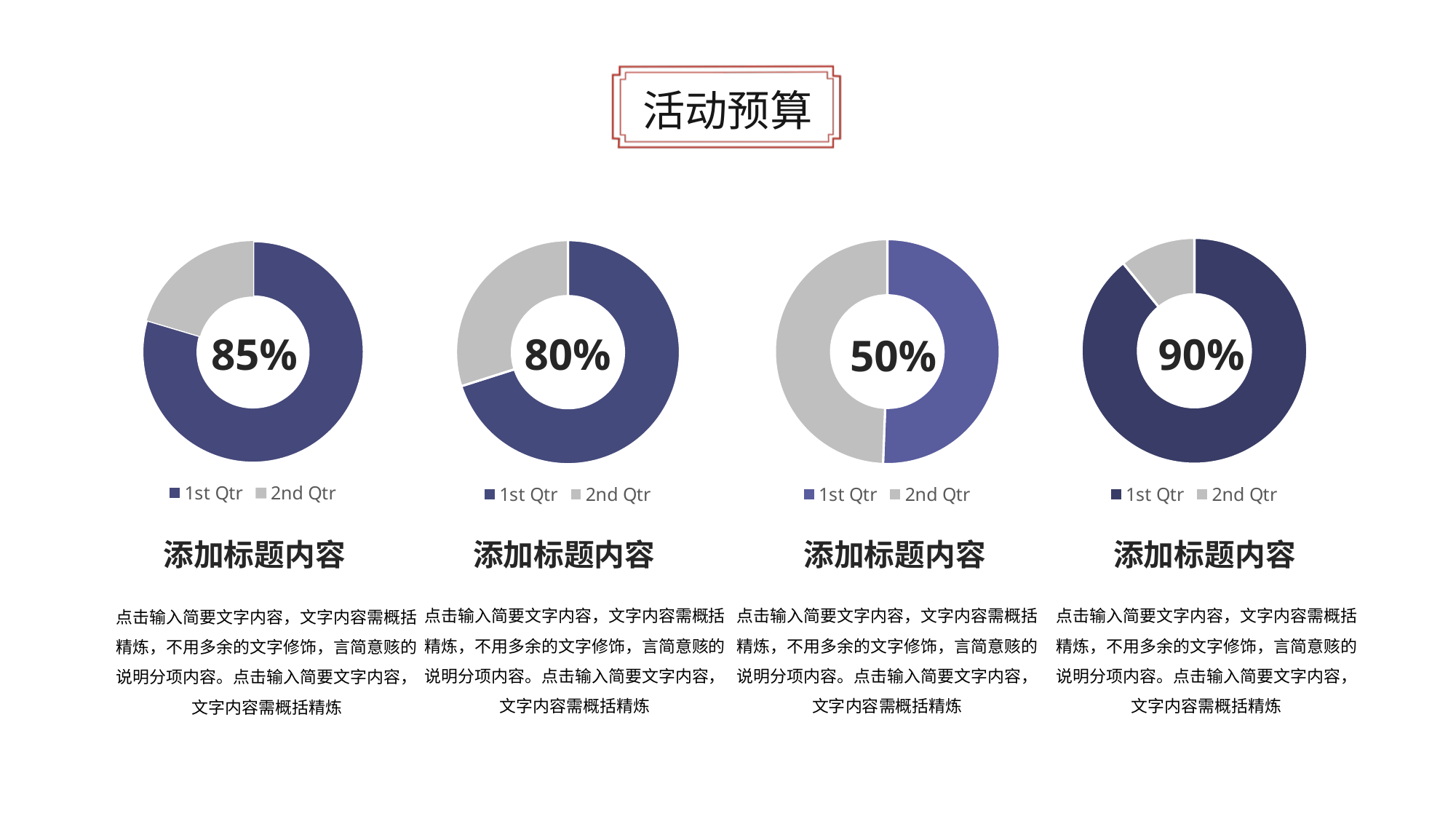
What kind of chart is the leftmost chart on the slide? doughnut chart What is the difference between the centre percentages of the rightmost chart and the third chart from the left? 40% What are the two legend entries shown under the second chart from the left? 1st Qtr and 2nd Qtr Which of the four charts shows the highest centre percentage? the rightmost chart (90%) How many entries does the legend of the leftmost chart list? 2 What percentage is printed in the centre of the second chart from the left? 80% What percentage is printed in the centre of the rightmost chart? 90% How many charts are shown on the slide? 4 In the leftmost chart, which slice is larger, 1st Qtr or 2nd Qtr? 1st Qtr In the rightmost chart, which slice is smaller, 1st Qtr or 2nd Qtr? 2nd Qtr What percentage is printed in the centre of the third chart from the left? 50% What percentage is printed in the centre of the leftmost chart? 85%